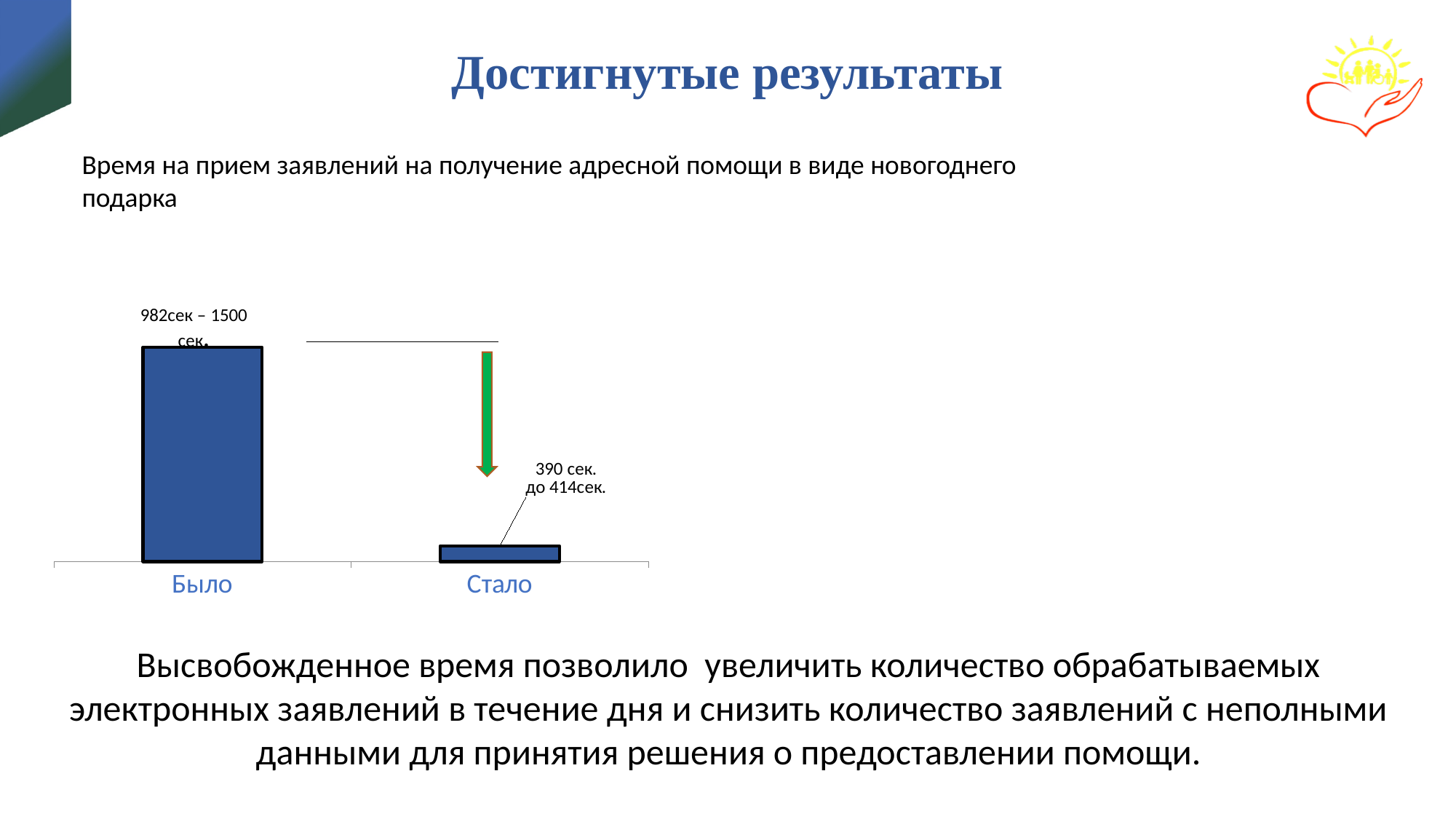
What data label is printed above the bar for "Было"? 982сек – 1500 сек. Which category has the lowest bar? Стало Which bar is taller, "Было" or "Стало"? Было What data label is printed for the bar "Стало"? 390 сек. до 414сек. Which category has the highest bar? Было How many categories are shown on the x axis of the chart? 2 What kind of chart is shown on the slide? bar chart Do the values rise or fall from "Было" to "Стало"? fall What does the text above the chart say the chart measures? Время на прием заявлений на получение адресной помощи в виде новогоднего подарка What are the category labels on the x axis of the chart? Было, Стало